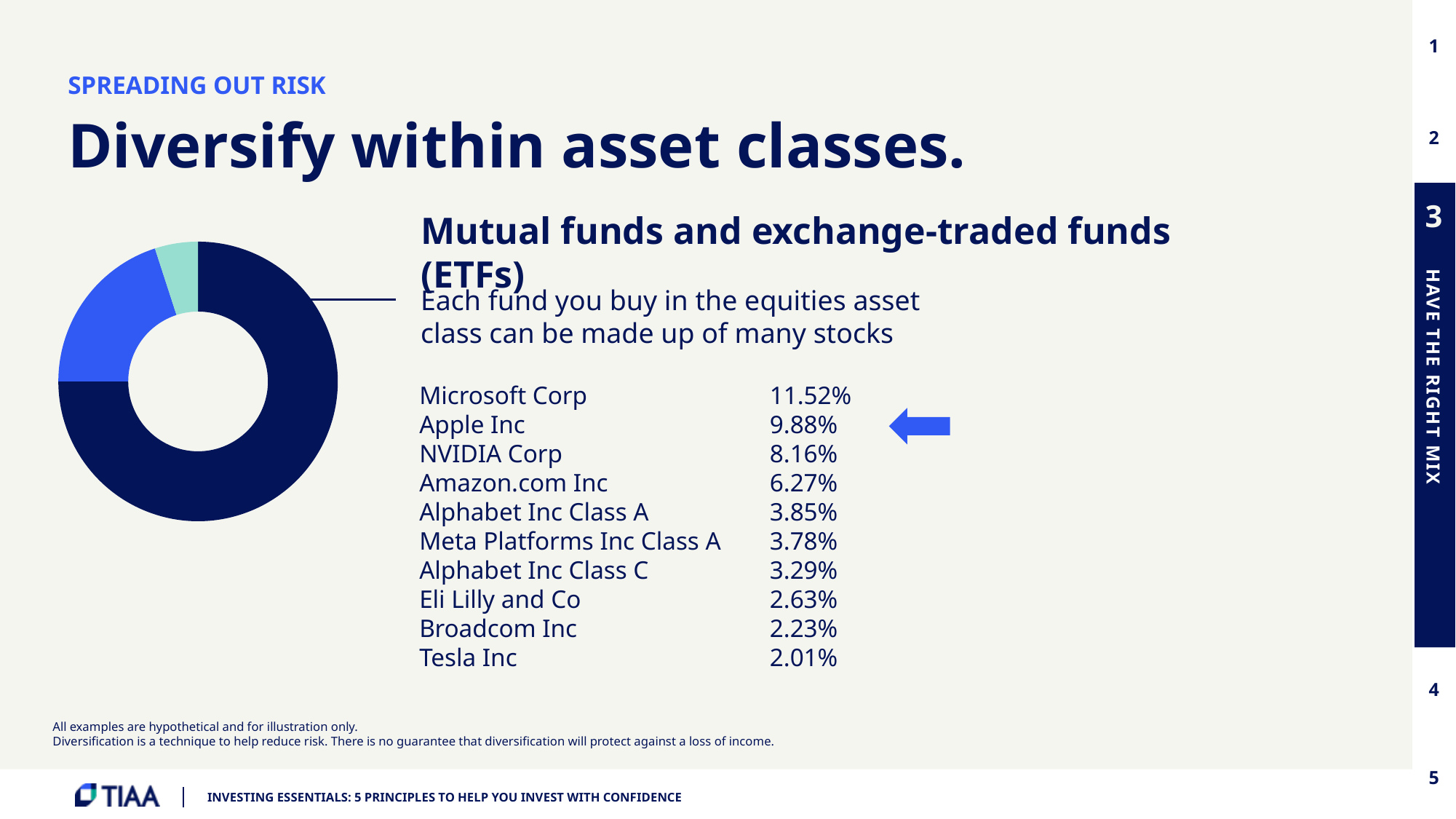
How many slices does the donut chart on the left contain? 3 Which slice of the donut chart is the smallest? The light teal slice Does the donut chart display a legend? No Which slice of the donut chart is the largest? The dark navy slice In the donut chart, which is larger: the medium blue slice or the light teal slice? The medium blue slice What kind of chart is shown on the left of the slide? Pie chart (donut) In the donut chart, which is larger: the dark navy slice or the medium blue slice? The dark navy slice Does the donut chart show data labels with values on its slices? No